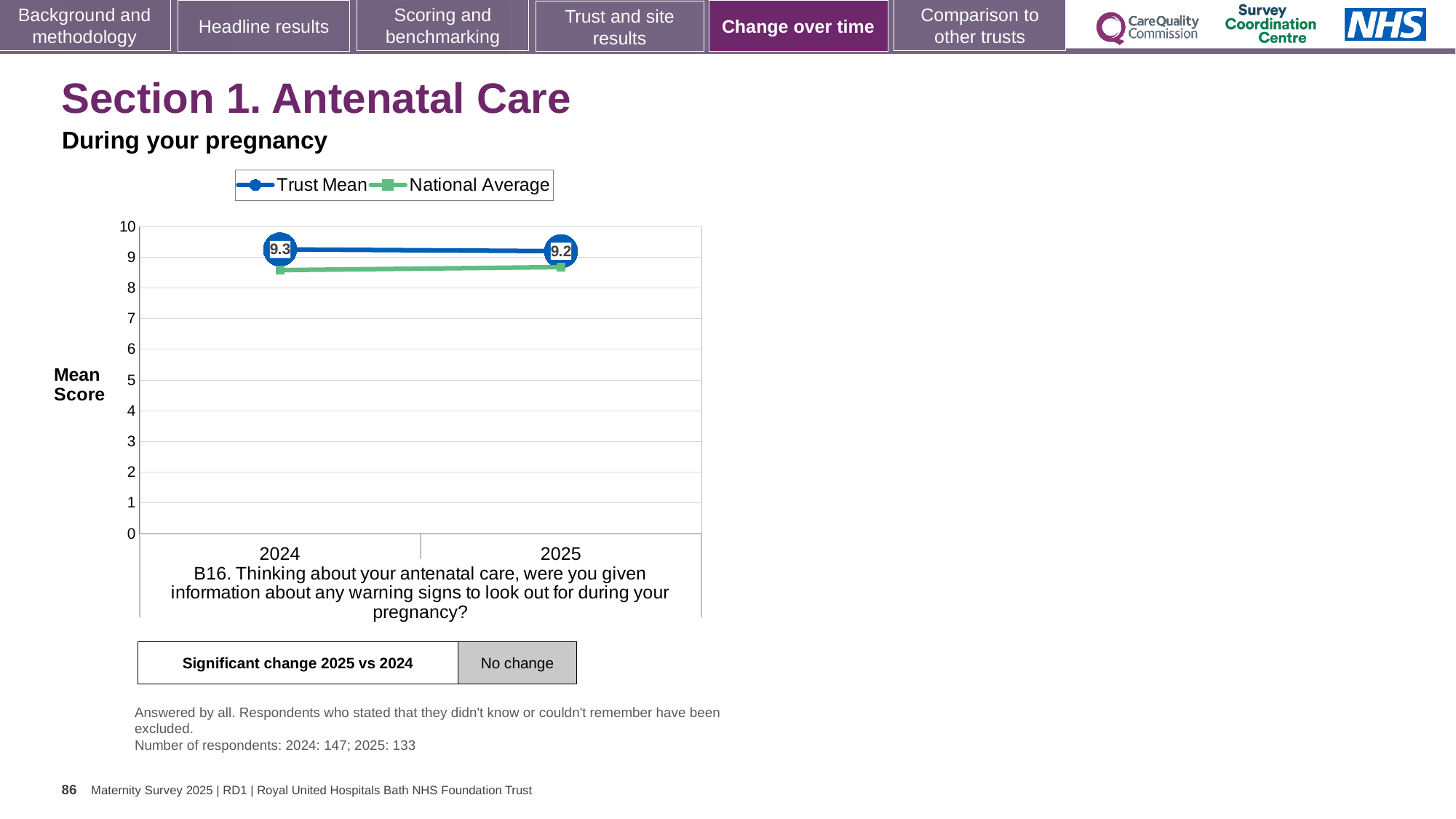
By how much did the Trust Mean change from 2024 to 2025? 0.1 What is the Trust Mean value for 2025? 9.2 How many years are shown on the x axis of the chart? 2 Is the National Average value for 2025 greater or less than 8? greater In which year was the Trust Mean higher, 2024 or 2025? 2024 Does the Trust Mean rise or fall from 2024 to 2025? Fall What is the Trust Mean value for 2024? 9.3 Is the National Average value for 2024 greater or less than 9? less What type of chart is shown on the slide? Line chart In 2025, which series has the higher value, Trust Mean or National Average? Trust Mean How many series does the chart legend list? 2 What is the label on the y axis of the chart? Mean Score